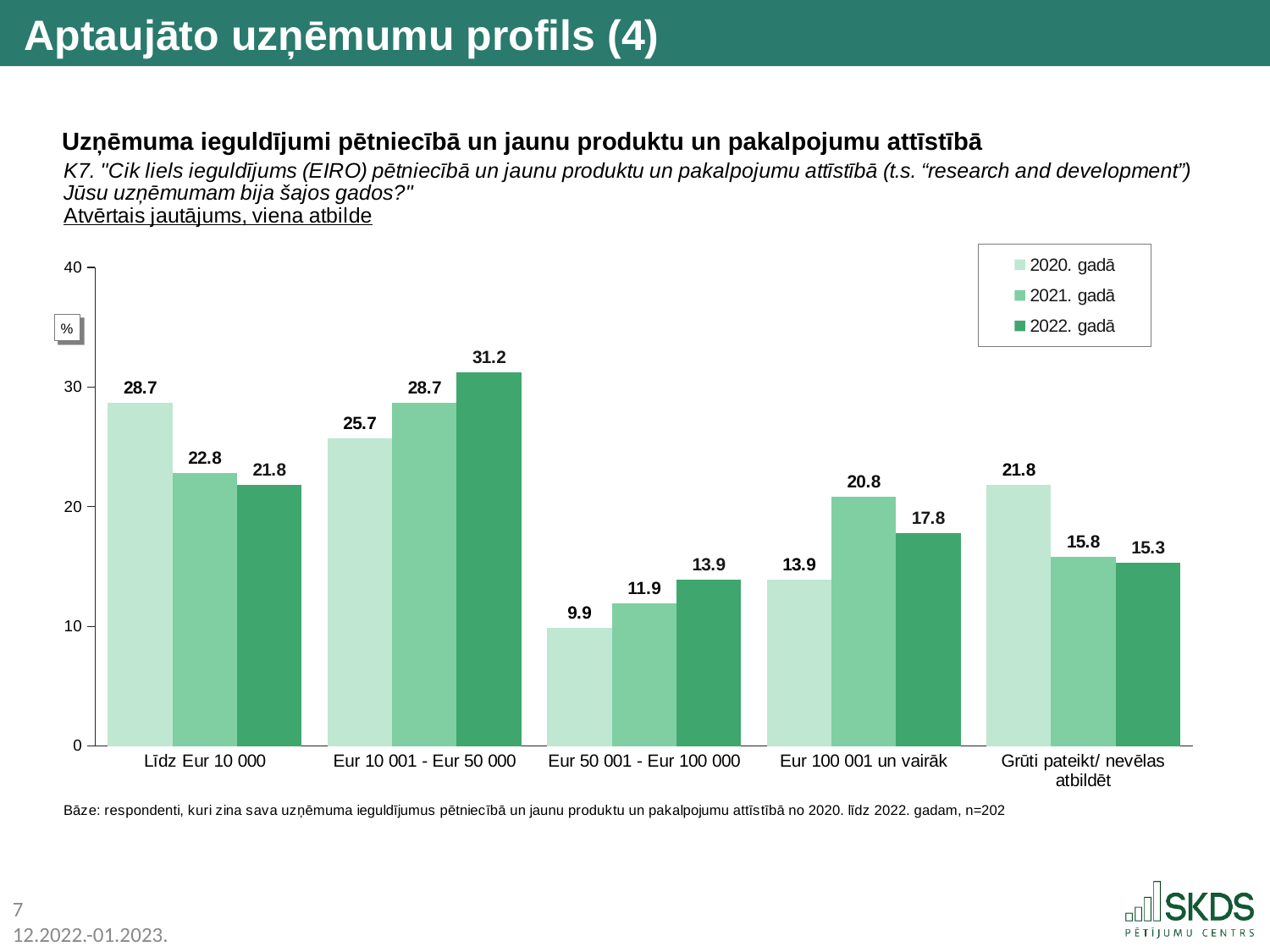
What is the value for "Eur 100 001 un vairāk" in the 2021. gadā series? 20.8 What is the third entry in the legend? 2022. gadā Which category has the highest value in the 2022. gadā series? Eur 10 001 - Eur 50 000 What kind of chart is shown on the slide? bar chart Which is larger for "Grūti pateikt/ nevēlas atbildēt": the 2020. gadā value or the 2022. gadā value? 2020. gadā What is the difference between the 2022. gadā and 2020. gadā values for "Eur 10 001 - Eur 50 000"? 5.5 Do the values for "Eur 50 001 - Eur 100 000" rise or fall from 2020. gadā to 2022. gadā? rise Which category has the lowest value in the 2020. gadā series? Eur 50 001 - Eur 100 000 How many categories are shown on the x axis? 5 What is the value for "Līdz Eur 10 000" in the 2020. gadā series? 28.7 How many series does the legend list? 3 What is the value for "Eur 10 001 - Eur 50 000" in the 2022. gadā series? 31.2